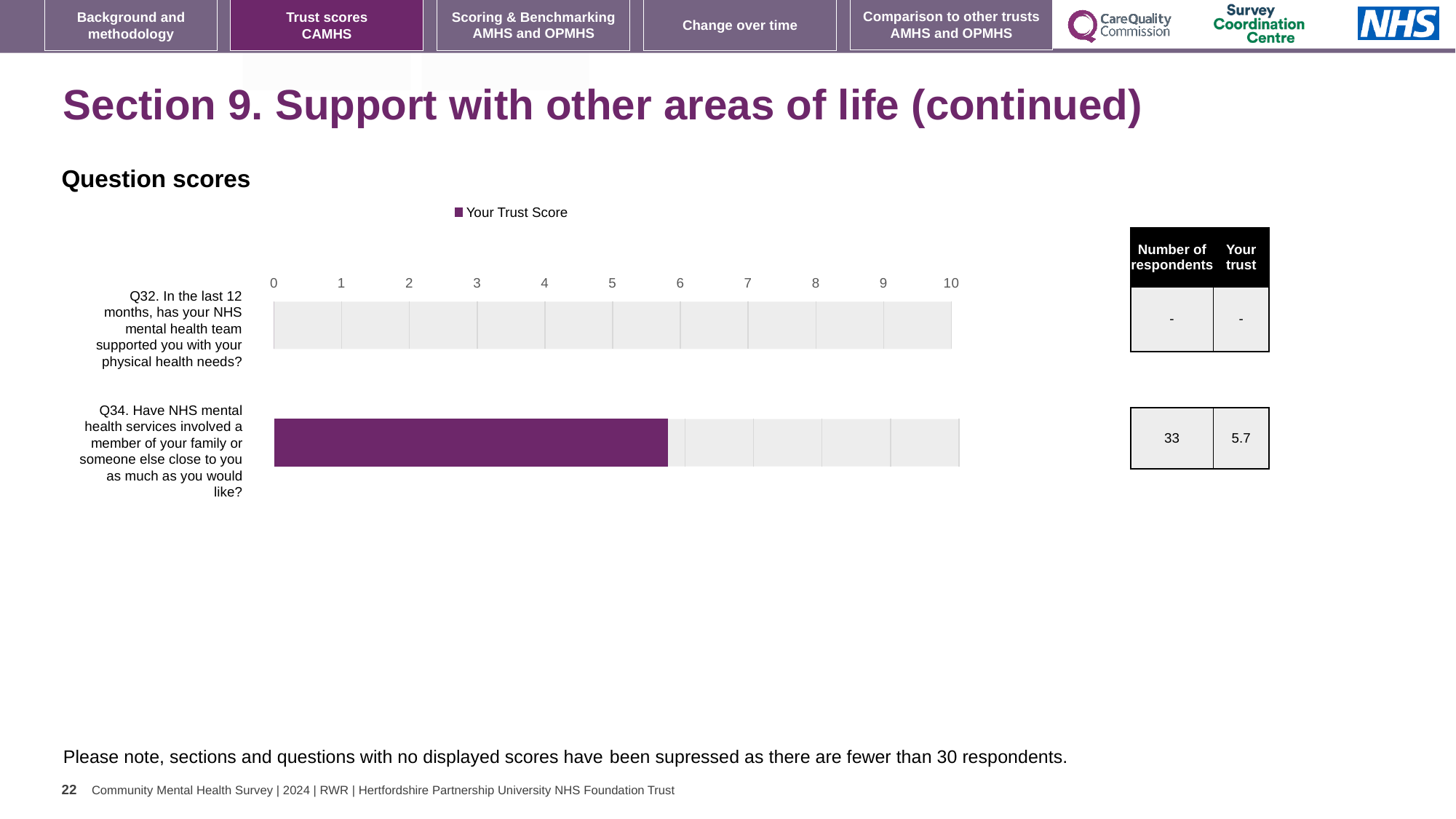
Which question has a plotted bar on the chart, Q32 or Q34? Q34 What is the maximum value shown on the chart's horizontal axis? 10 How many series does the chart legend list? 1 How many respondents answered Q34 according to the table next to the chart? 33 What is the Your Trust Score for Q34 (Have NHS mental health services involved a member of your family or someone else close to you as much as you would like?)? 5.7 What is the name of the series shown in the chart legend? Your Trust Score Is the Your Trust Score for Q34 greater or less than 5? greater What kind of chart is shown under 'Question scores'? bar chart What is shown in the table for the number of respondents and trust score for Q32? - Is the Your Trust Score for Q34 greater or less than 6? less How many questions (categories) are listed on the chart? 2